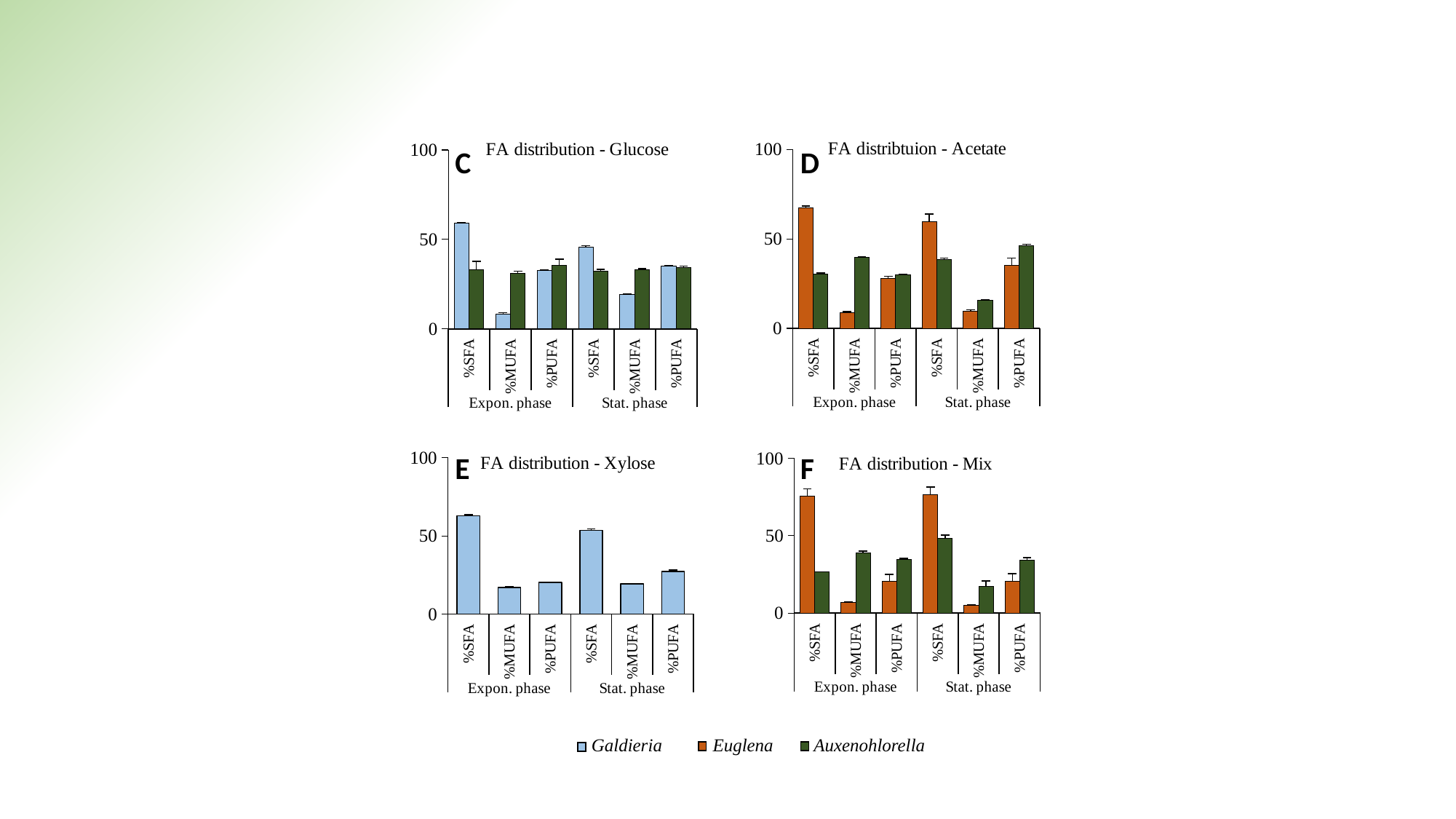
How many series does the shared legend at the bottom of the slide list? 3 In the 'FA distribution - Mix' chart, is the Euglena value for %MUFA in the Stat. phase greater or less than 50? less In the 'FA distribtuion - Acetate' chart, is the Euglena value for %SFA in the Expon. phase greater or less than 50? greater In the 'FA distribution - Mix' chart, which fatty acid class has the lowest Euglena value in the Stat. phase? %MUFA What kind of chart is the 'FA distribution - Glucose' chart? bar chart Which series is shown in orange in the legend? Euglena In the 'FA distribtuion - Acetate' chart, for %MUFA in the Expon. phase, which is larger: Euglena or Auxenohlorella? Auxenohlorella In the 'FA distribution - Xylose' chart, which bar is the highest? %SFA, Expon. phase In the 'FA distribution - Glucose' chart, is the Galdieria value for %SFA in the Expon. phase greater or less than 50? greater In the 'FA distribution - Xylose' chart, how many bars are plotted? 6 In the 'FA distribution - Glucose' chart, for %SFA in the Expon. phase, which is larger: Galdieria or Auxenohlorella? Galdieria In the 'FA distribution - Glucose' chart, which fatty acid class has the lowest Galdieria value in the Expon. phase? %MUFA